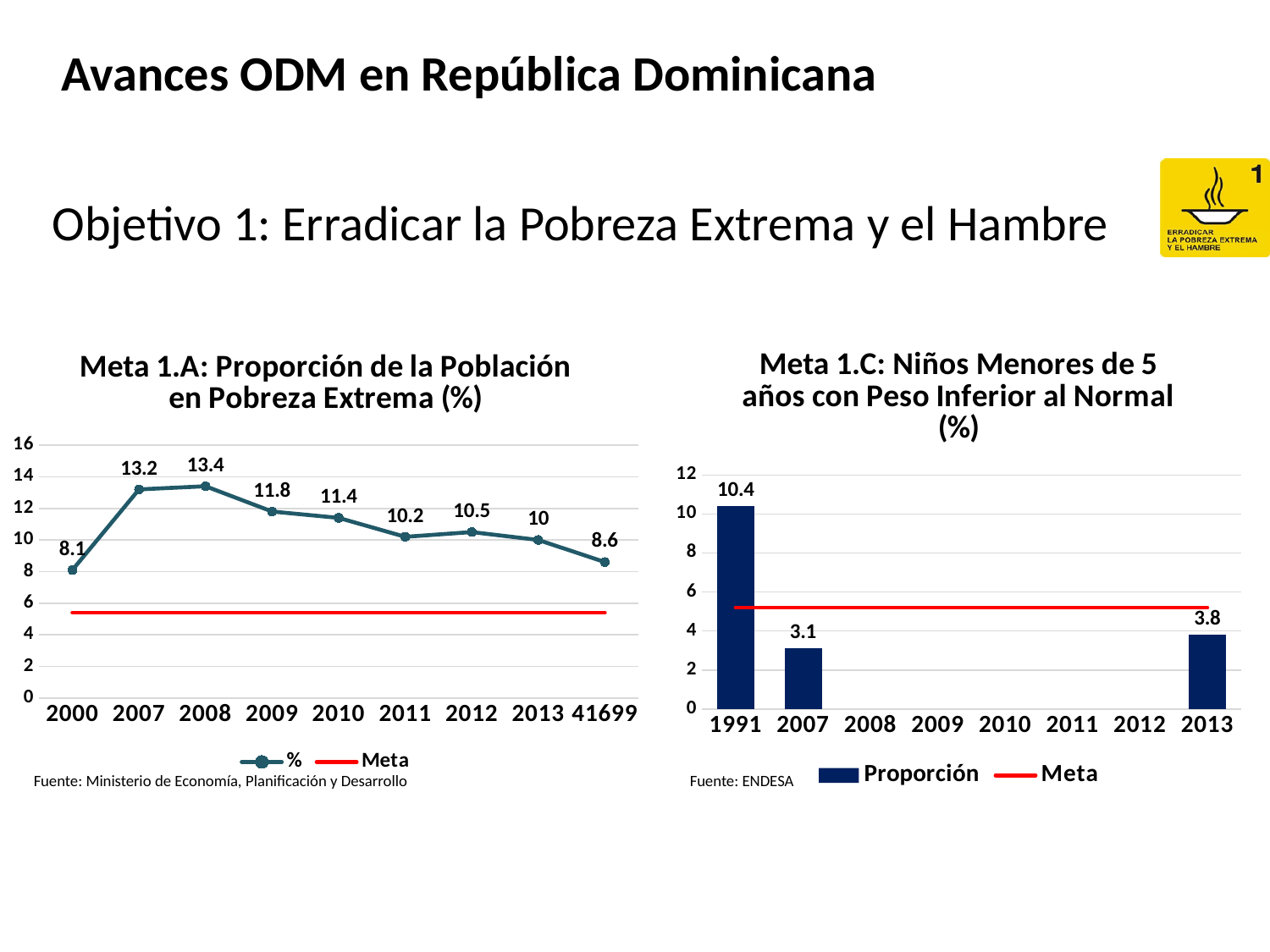
In the chart 'Meta 1.A: Proporción de la Población en Pobreza Extrema (%)', which year has the highest value? 2008 In the chart 'Meta 1.C: Niños Menores de 5 años con Peso Inferior al Normal (%)', what is the difference between the values for 1991 and 2013? 6.6 In the chart 'Meta 1.C: Niños Menores de 5 años con Peso Inferior al Normal (%)', which is larger, the value for 2007 or the value for 2013? 2013 In the chart 'Meta 1.A: Proporción de la Población en Pobreza Extrema (%)', what is the value for 2008? 13.4 In the chart 'Meta 1.A: Proporción de la Población en Pobreza Extrema (%)', what is the difference between the values for 2007 and 2013? 3.2 In the chart 'Meta 1.C: Niños Menores de 5 años con Peso Inferior al Normal (%)', what is the value for 1991? 10.4 In the chart 'Meta 1.A: Proporción de la Población en Pobreza Extrema (%)', what is the value for 2000? 8.1 In the chart 'Meta 1.C: Niños Menores de 5 años con Peso Inferior al Normal (%)', which year has the lowest value? 2007 In the chart 'Meta 1.A: Proporción de la Población en Pobreza Extrema (%)', how many series does the legend list? 2 In the chart 'Meta 1.A: Proporción de la Población en Pobreza Extrema (%)', is the Meta line greater or less than 6? less What kind of chart is 'Meta 1.C: Niños Menores de 5 años con Peso Inferior al Normal (%)'? Bar chart What kind of chart is 'Meta 1.A: Proporción de la Población en Pobreza Extrema (%)'? Line chart